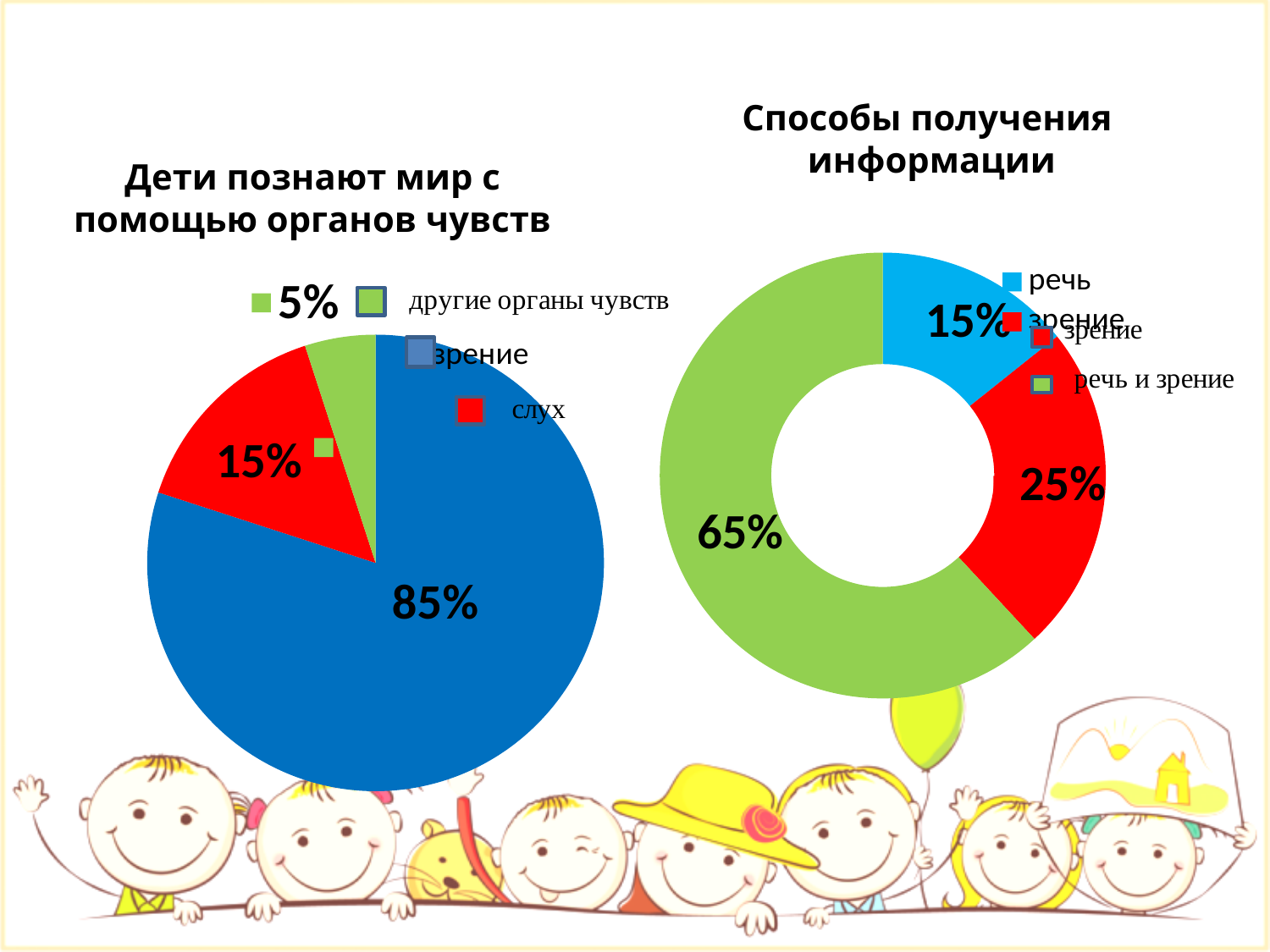
In the chart titled "Дети познают мир с помощью органов чувств", which category has the smallest slice? другие органы чувств What kind of chart is the one titled "Дети познают мир с помощью органов чувств"? pie chart In the chart titled "Способы получения информации", what percentage is shown for речь и зрение? 65% In the chart titled "Дети познают мир с помощью органов чувств", which category has the largest slice? зрение In the chart titled "Дети познают мир с помощью органов чувств", what percentage is shown for слух? 15% In the chart titled "Способы получения информации", what percentage is shown for зрение? 25% In the chart titled "Дети познают мир с помощью органов чувств", what percentage is shown for другие органы чувств? 5% In the chart titled "Дети познают мир с помощью органов чувств", what percentage is shown for зрение? 85% In the chart titled "Способы получения информации", which is larger, зрение or речь? зрение How many categories does the legend of the chart titled "Способы получения информации" list? 3 In the chart titled "Дети познают мир с помощью органов чувств", what is the difference between the зрение and слух percentages? 70% In the chart titled "Способы получения информации", what percentage is shown for речь? 15%